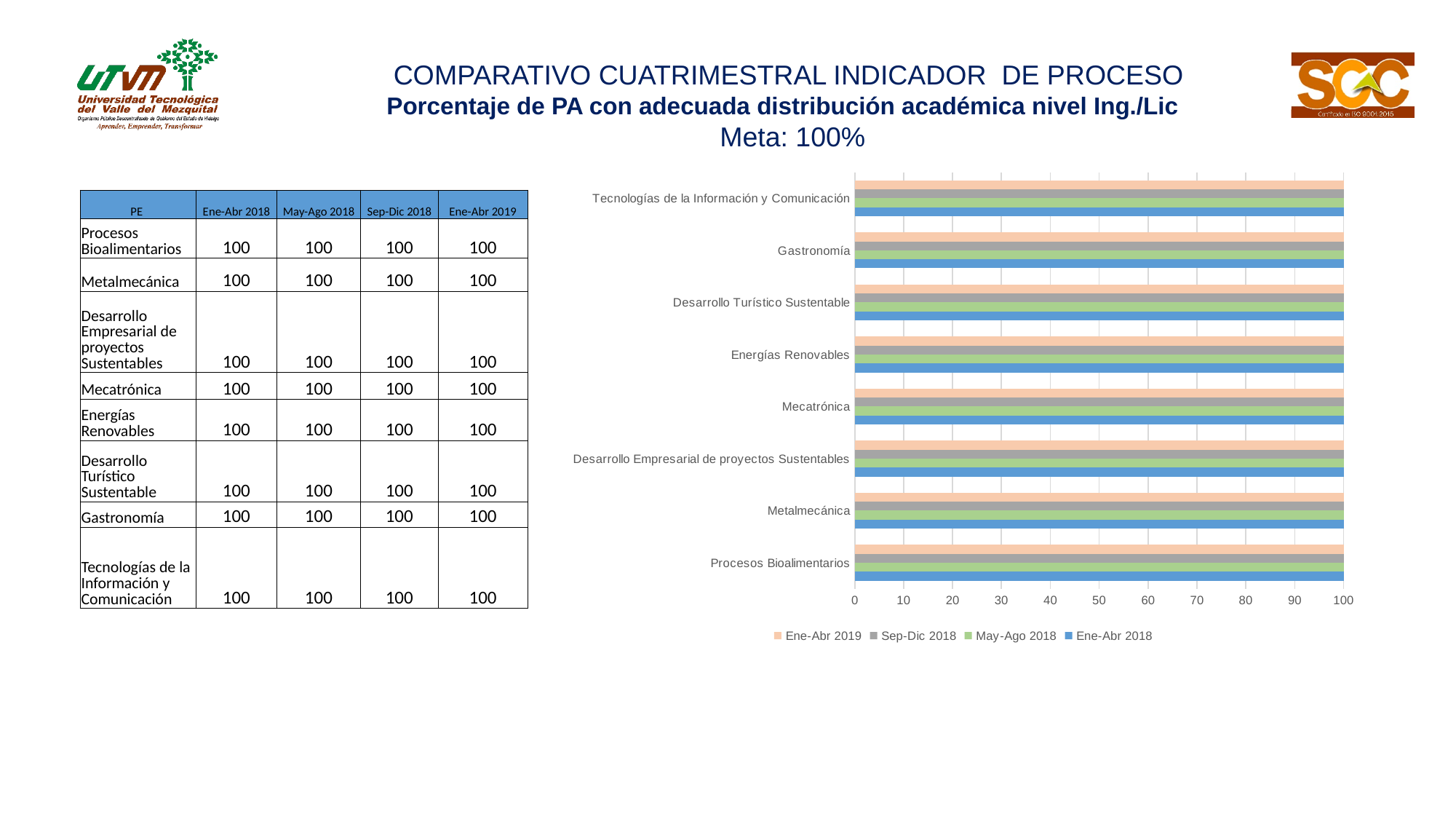
What is the value for Energías Renovables in the May-Ago 2018 series? 100 How many categories (PE) are plotted on the chart? 8 What is the value for Mecatrónica in the Ene-Abr 2018 series? 100 What kind of chart is shown on the slide? bar chart Is the value for Procesos Bioalimentarios in the Sep-Dic 2018 series greater or less than 50? greater What is the highest value shown on the chart's horizontal axis? 100 Which series is shown in blue in the chart legend? Ene-Abr 2018 What is the value for Gastronomía in the Ene-Abr 2019 series? 100 How many series does the chart legend list? 4 What is the value for Tecnologías de la Información y Comunicación in the Sep-Dic 2018 series? 100 What is the difference between the Ene-Abr 2019 value for Desarrollo Turístico Sustentable and the Ene-Abr 2018 value for Desarrollo Turístico Sustentable? 0 Is the value for Metalmecánica in the Ene-Abr 2019 series greater or less than 90? greater